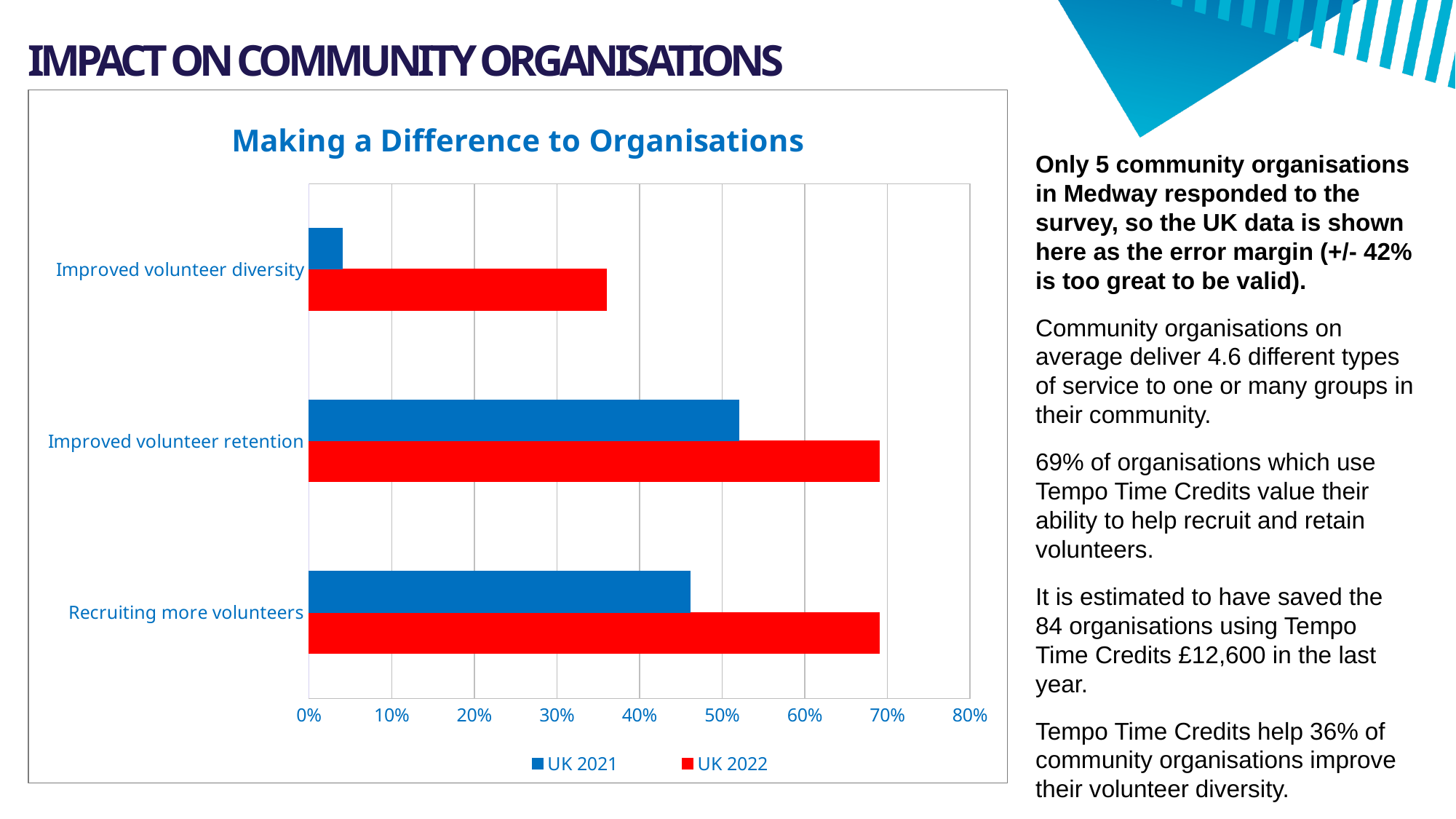
Which category has the lowest value for the UK 2022 series? Improved volunteer diversity Which colour represents the UK 2022 series? Red Is the UK 2021 value for Improved volunteer diversity greater or less than 10%? less Is the UK 2022 value for Improved volunteer diversity greater or less than 30%? greater For Improved volunteer diversity, which series has the larger value, UK 2021 or UK 2022? UK 2022 Is the UK 2022 value for Improved volunteer retention greater or less than 60%? greater What kind of chart is shown on the slide? Bar chart Which category has the highest value for the UK 2021 series? Improved volunteer retention How many categories are shown on the chart? 3 How many series does the chart legend list? 2 What is the title of the chart? Making a Difference to Organisations